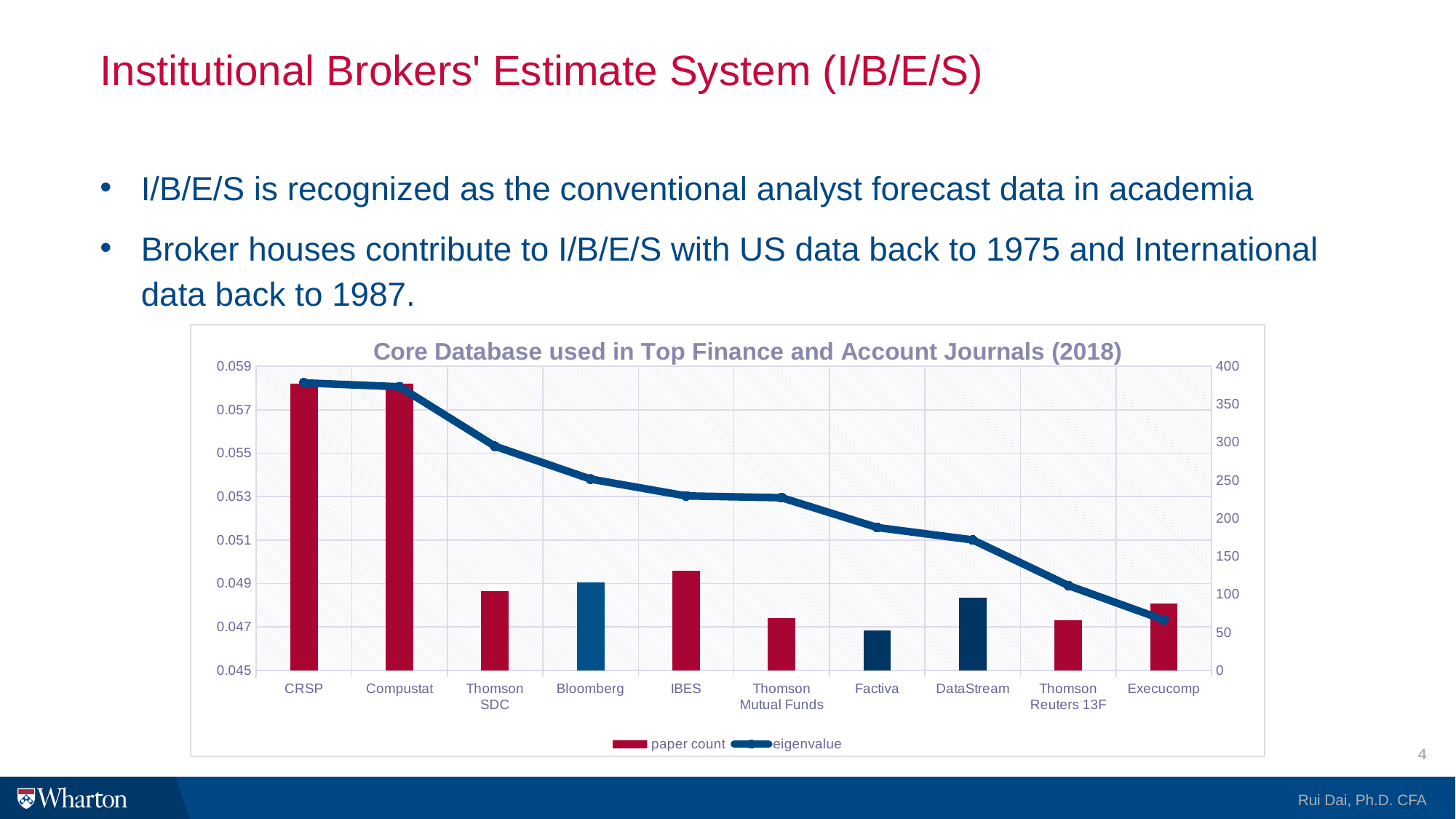
Does the eigenvalue line rise or fall from CRSP to Execucomp? Fall Is the paper count bar for Execucomp greater or less than 100 on the right axis? less How many databases (categories) are shown on the x axis of the chart? 10 Is the paper count bar for IBES greater or less than 100 on the right axis? greater Which database has the lowest paper count bar? Factiva What kind of chart is shown on the slide? Combined bar and line chart How many series does the chart legend list? 2 Which has the larger paper count bar, IBES or DataStream? IBES Is the paper count bar for CRSP greater or less than 350 on the right axis? greater What is the title of the chart? Core Database used in Top Finance and Account Journals (2018) Which series is drawn as a line in the chart? eigenvalue